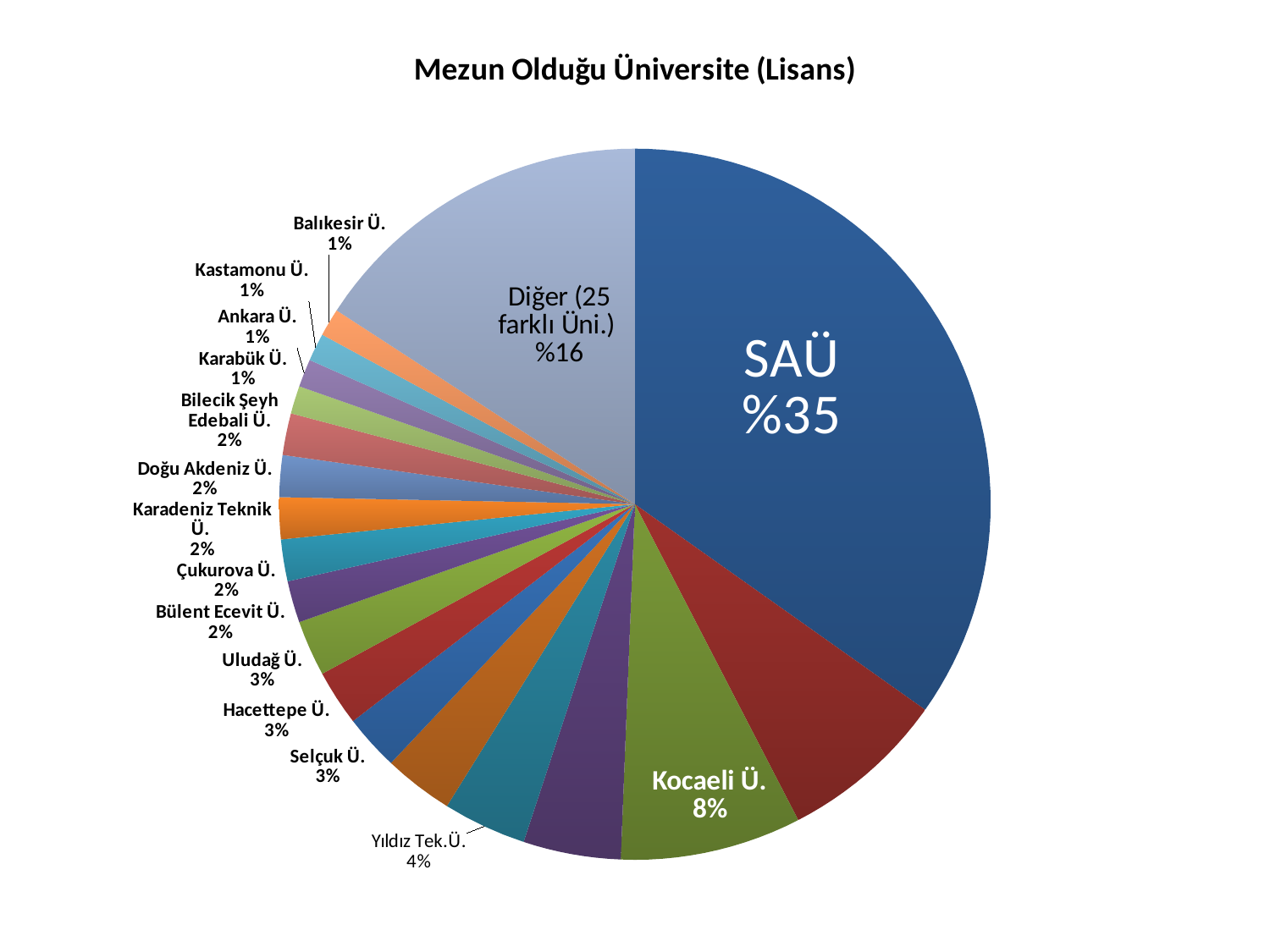
What is the value shown for Yıldız Tek.Ü.? 4% What is the value shown for Hacettepe Ü.? 3% Which university has the largest slice of the pie? SAÜ What is the value shown for the 'Diğer (25 farklı Üni.)' slice? %16 What is the difference in percentage points between SAÜ and Kocaeli Ü.? 27 What is the value shown for Karabük Ü.? 1% What is the title of the chart? Mezun Olduğu Üniversite (Lisans) What kind of chart is shown on the slide? Pie chart What is the difference in percentage points between Kocaeli Ü. and Yıldız Tek.Ü.? 4 Which is larger, the slice for Kocaeli Ü. or the slice for Selçuk Ü.? Kocaeli Ü. What is the value shown for Kocaeli Ü.? 8% What share of the pie does SAÜ hold? %35